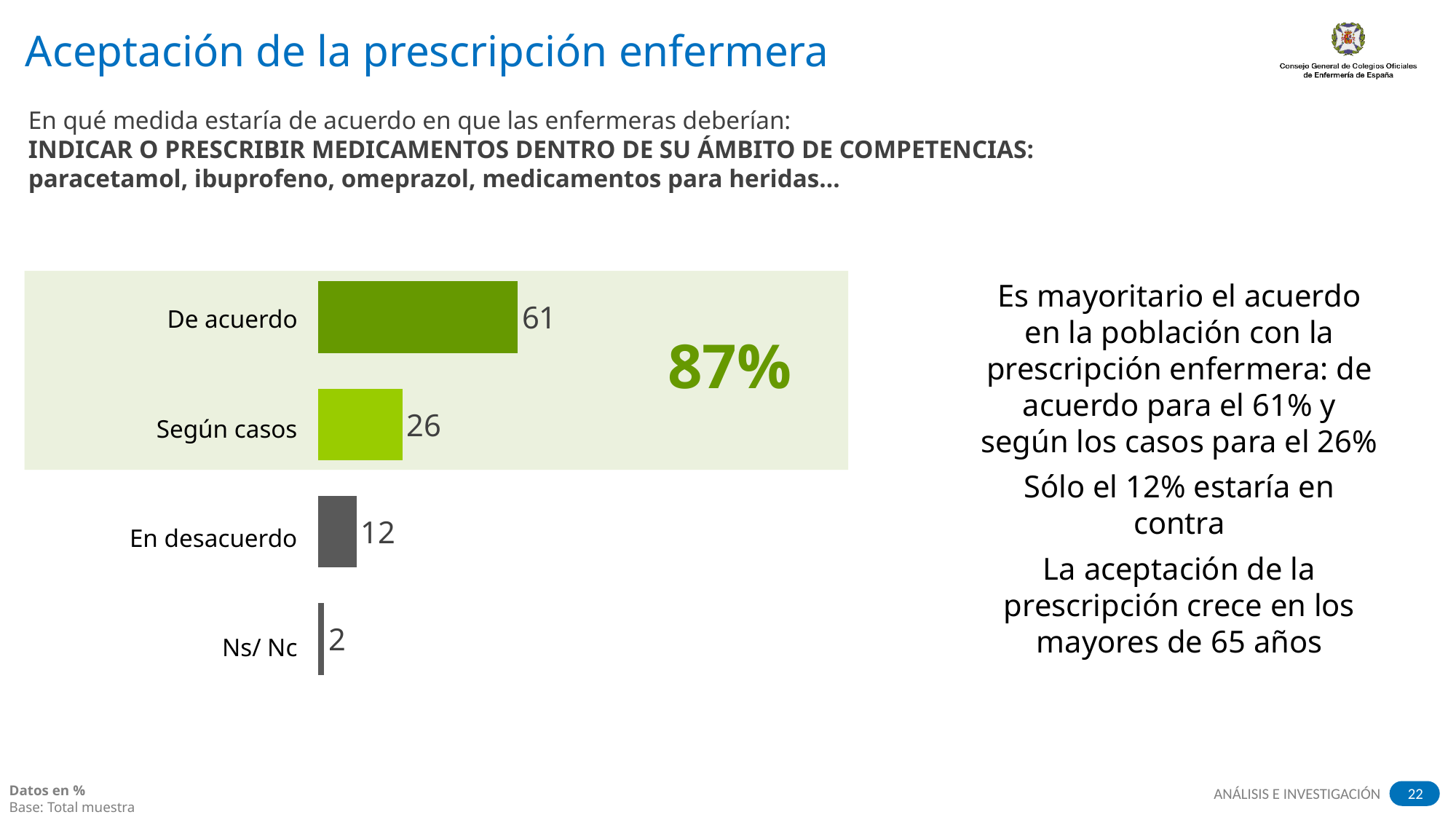
How many categories are shown in the chart? 4 What combined percentage is highlighted in the shaded area covering "De acuerdo" and "Según casos"? 87% Which is larger, the value for "En desacuerdo" or the value for "Ns/ Nc"? En desacuerdo Which category has the lowest value? Ns/ Nc What kind of chart is shown on the slide? Bar chart What is the value for "Ns/ Nc"? 2 What is the value for "De acuerdo"? 61 What is the difference between the values for "Según casos" and "En desacuerdo"? 14 What is the difference between the values for "De acuerdo" and "Según casos"? 35 What is the value for "En desacuerdo"? 12 Which category has the highest value? De acuerdo What is the value for "Según casos"? 26